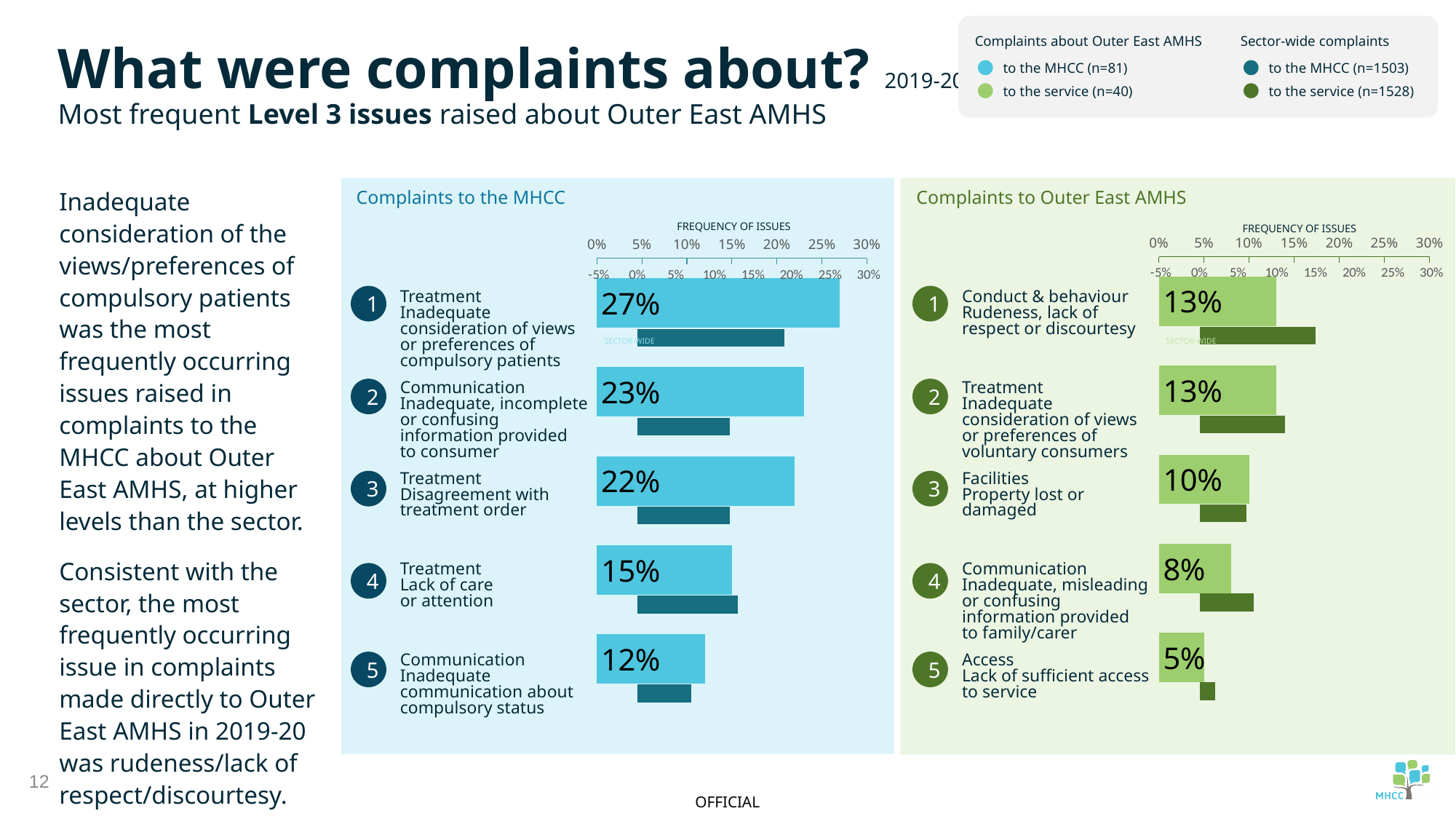
In the 'Complaints to Outer East AMHS' chart, is the sector-wide value for issue 5 (Access – Lack of sufficient access to service) greater or less than 5%? less How many issues are listed in the 'Complaints to the MHCC' chart? 5 In the 'Complaints to the MHCC' chart, what is the frequency for issue 1, Treatment – Inadequate consideration of views or preferences of compulsory patients? 27% In the 'Complaints to the MHCC' chart, what is the frequency for issue 5, Communication – Inadequate communication about compulsory status? 12% In the 'Complaints to the MHCC' chart, what is the difference in percentage points between issue 1 (27%) and issue 2 (23%)? 4 percentage points In the 'Complaints to Outer East AMHS' chart, which is larger: the frequency for Facilities – Property lost or damaged, or for Communication – Inadequate, misleading or confusing information provided to family/carer? Facilities – Property lost or damaged In the 'Complaints to the MHCC' chart, which issue has the highest frequency? Treatment – Inadequate consideration of views or preferences of compulsory patients In the 'Complaints to Outer East AMHS' chart, what is the frequency for issue 3, Facilities – Property lost or damaged? 10% According to the legend at the top right, how many complaints about Outer East AMHS were made to the MHCC (n)? n=81 What kind of chart is used to show the frequency of issues in the 'Complaints to Outer East AMHS' panel? Bar chart In the 'Complaints to Outer East AMHS' chart, which issue has the lowest frequency? Access – Lack of sufficient access to service In the 'Complaints to the MHCC' chart, is the sector-wide value for issue 1 (Treatment – Inadequate consideration of views or preferences of compulsory patients) greater or less than 15%? greater